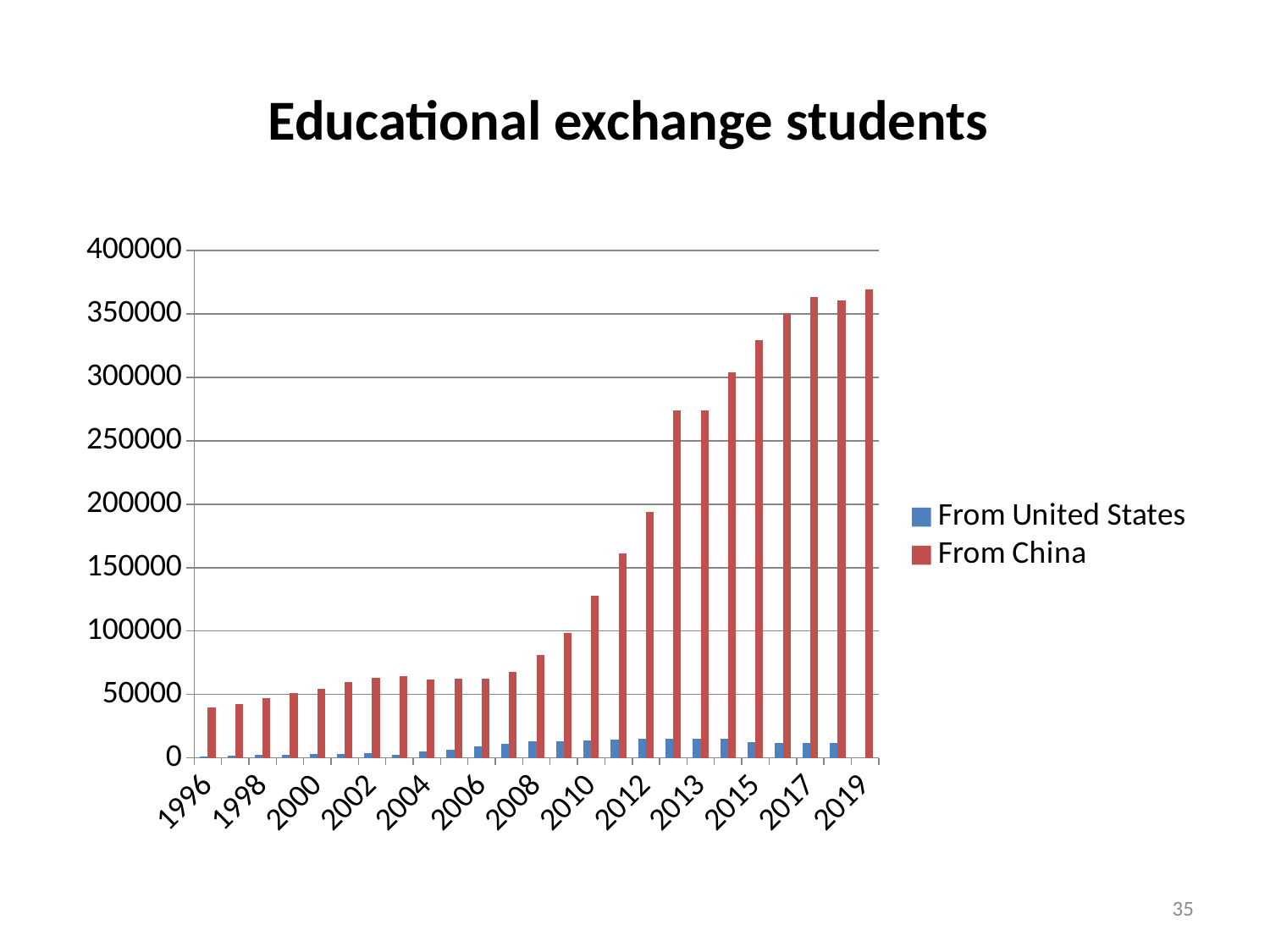
Which is larger in 2010: the value for From China or the value for From United States? From China Do the values for From China generally rise or fall from 1996 to 2019? rise What is the title of the chart? Educational exchange students Which series is shown in red? From China Is the value for From China in 1996 greater or less than 50000? less What kind of chart is shown on the slide? bar chart Is the value for From China in 2008 greater or less than 100000? less Is the value for From China in 2015 greater or less than 300000? greater How many series does the legend list? 2 Which year has the highest value for From China? 2019 Which year has the lowest value for From China? 1996